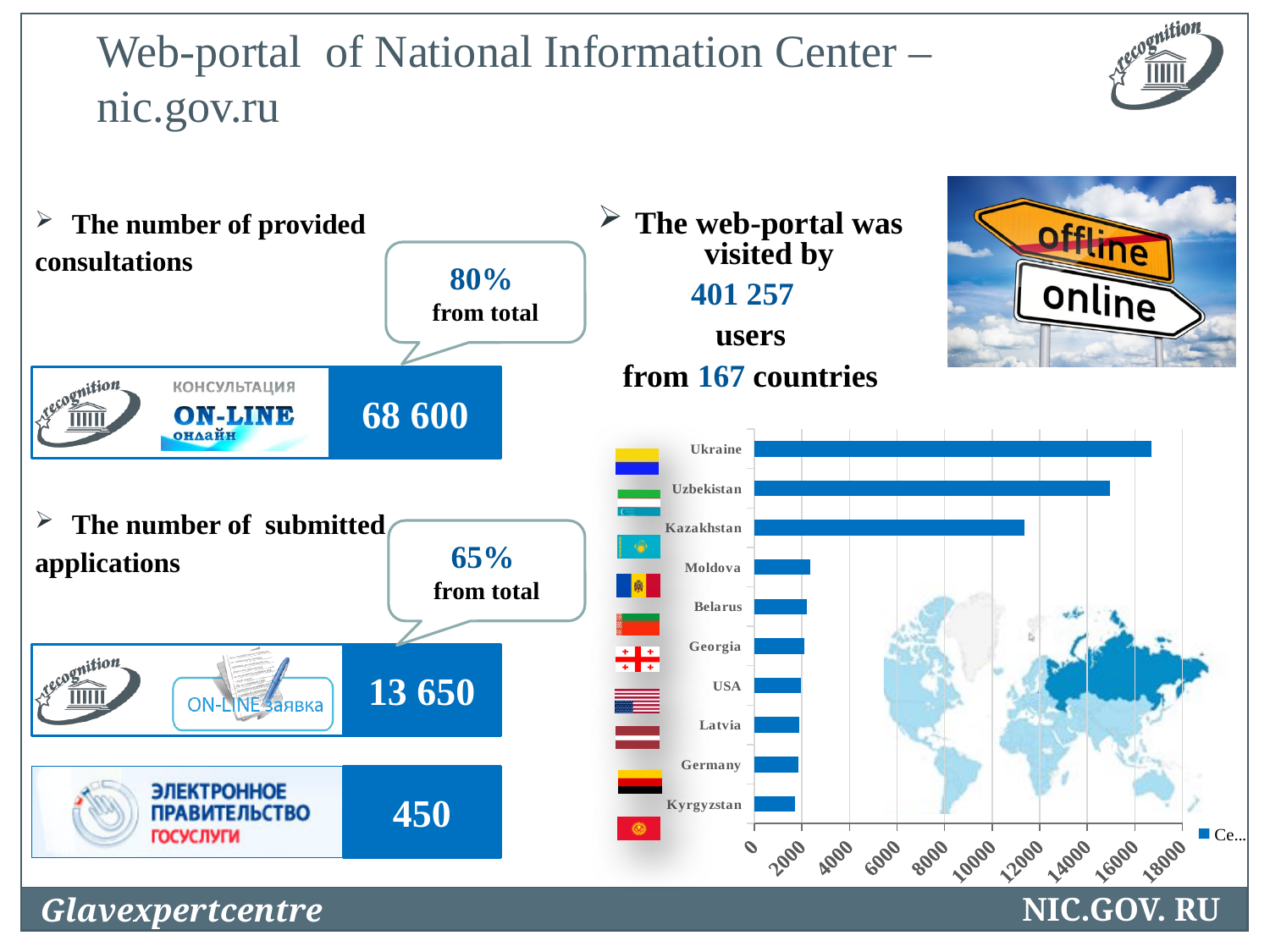
Is the value for Kazakhstan greater or less than 12000? less Do the bar values increase or decrease going from the top country (Ukraine) to the bottom country (Kyrgyzstan)? decrease Is the value for Kazakhstan greater or less than 10000? greater Which has a larger value, Kazakhstan or Moldova? Kazakhstan Which has a larger value, Ukraine or Uzbekistan? Ukraine Is the value for Moldova greater or less than 4000? less What kind of chart is shown on the slide? bar chart How many countries are listed on the chart? 10 What is the highest tick value shown on the horizontal axis of the chart? 18000 Which country has the highest value on the chart? Ukraine